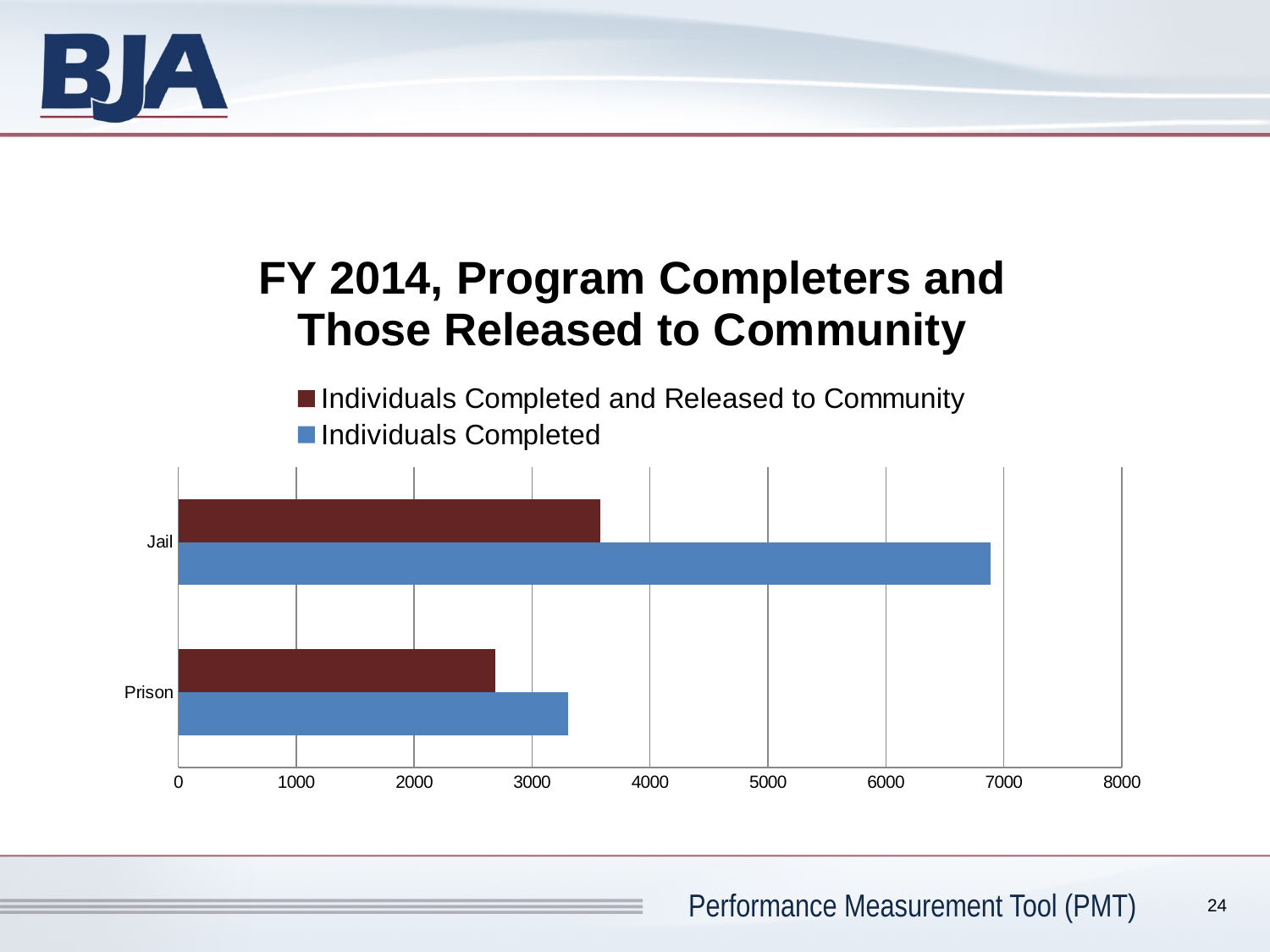
What is the title of the chart? FY 2014, Program Completers and Those Released to Community What kind of chart is shown on the slide? bar chart Which series is shown in blue in the legend? Individuals Completed Is the value for Individuals Completed for Jail greater or less than 6000? greater For Jail, which is larger: Individuals Completed or Individuals Completed and Released to Community? Individuals Completed How many series does the legend list? 2 How many categories are shown on the vertical axis? 2 Is the value for Individuals Completed for Prison greater or less than 4000? less Which category has the lower value for Individuals Completed and Released to Community? Prison Which category has the higher value for Individuals Completed, Jail or Prison? Jail Is the value for Individuals Completed and Released to Community for Prison greater or less than 3000? less